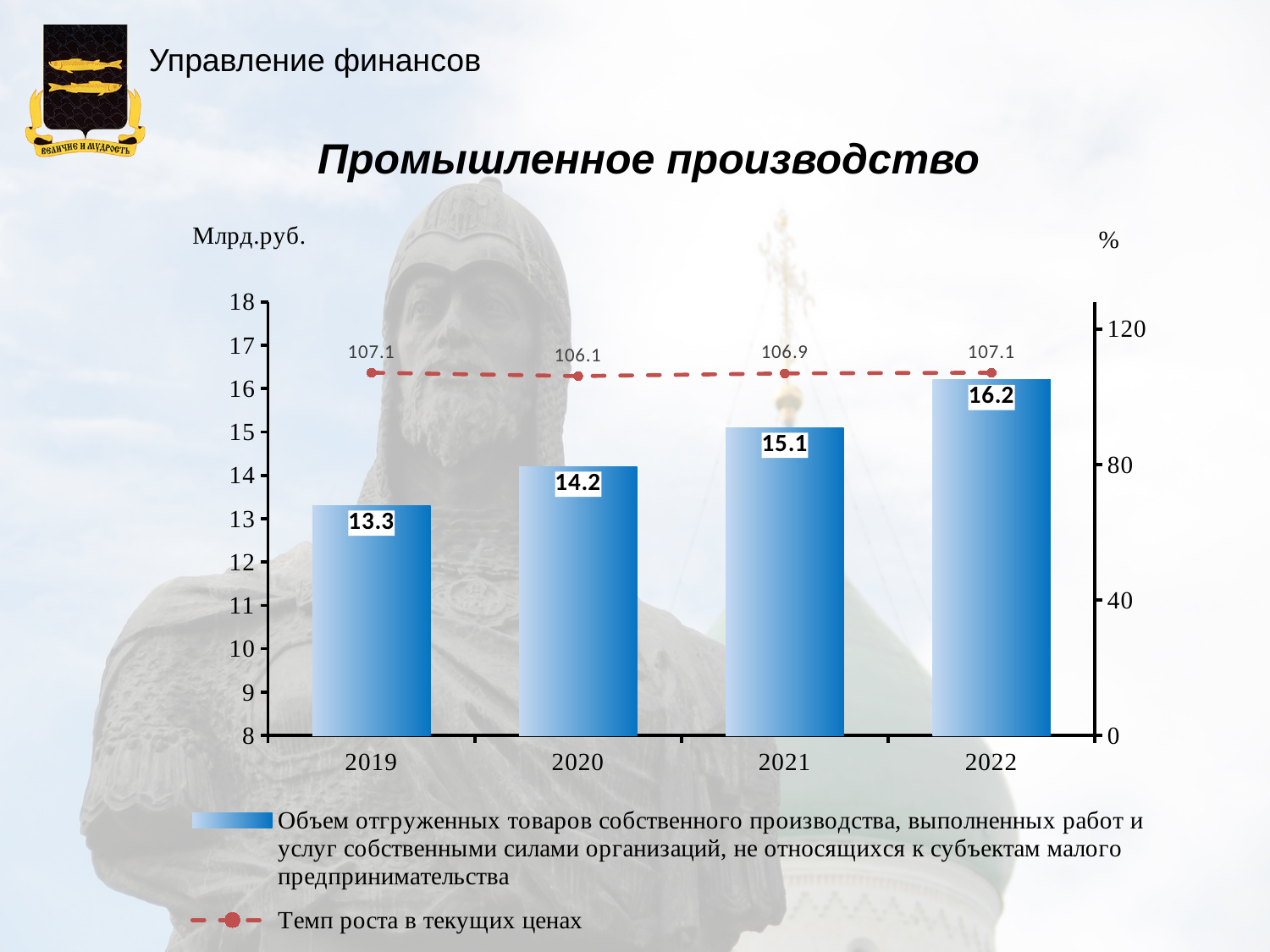
Which year has the lowest growth rate value on the dashed line? 2020 What is the growth rate (Темп роста в текущих ценах) value for 2021? 106.9 Which is larger, the bar value for 2020 or for 2021? 2021 How many series does the legend list? 2 Do the bar values rise or fall from 2019 to 2022? rise Which year has the highest bar value? 2022 What is the value of the bar for 2019? 13.3 What is the difference between the bar values for 2022 and 2019? 2.9 What is the growth rate (Темп роста в текущих ценах) value for 2020? 106.1 What is the value of the bar for 2022? 16.2 How many years are shown on the x axis? 4 What is the title of the chart? Промышленное производство